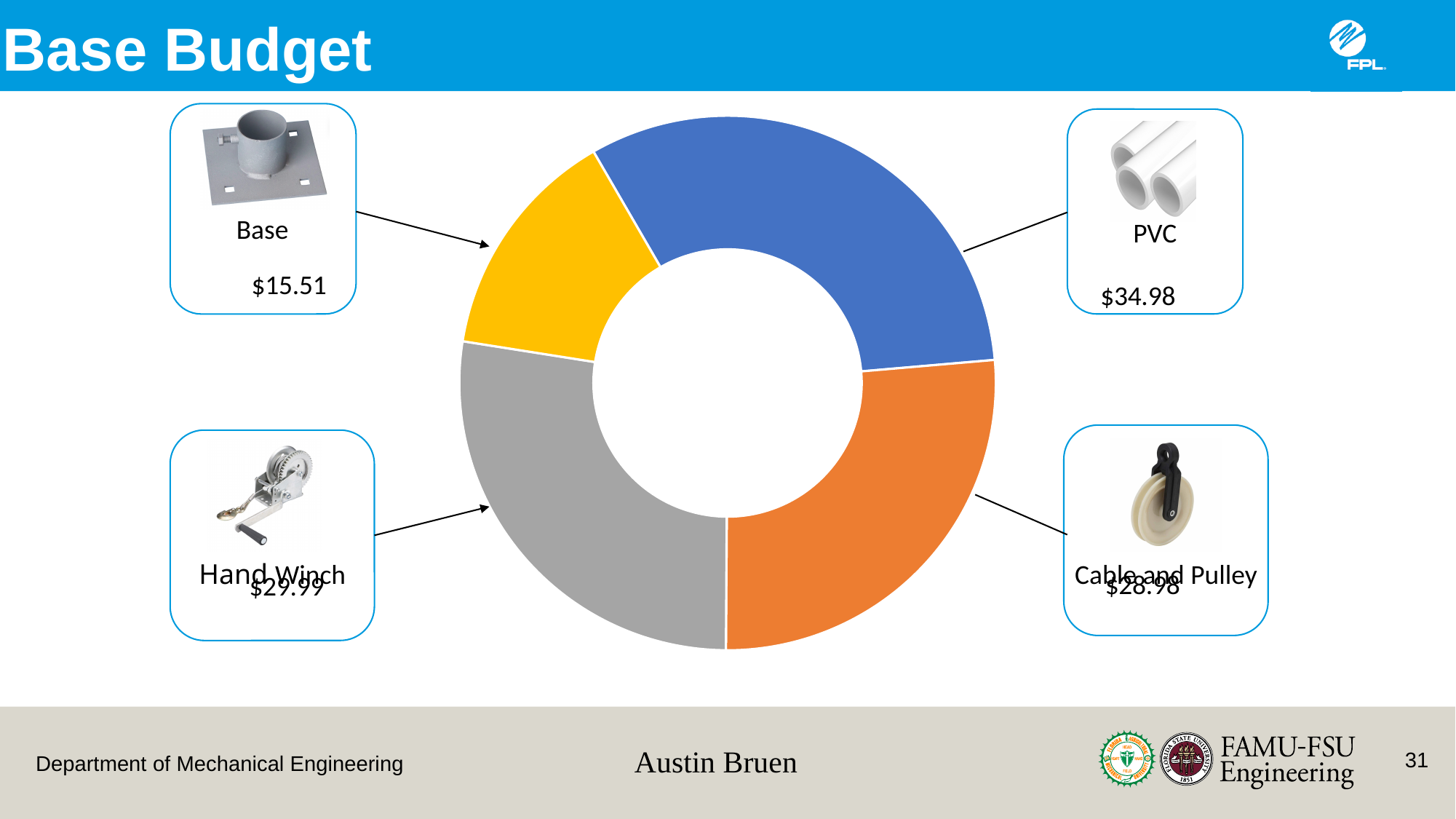
Which component has the highest cost in the Base Budget chart? PVC What is the cost of the Cable and Pulley in the Base Budget chart? $28.98 How many components are shown in the Base Budget chart? 4 What is the cost of the Hand Winch in the Base Budget chart? $29.99 What is the cost of the PVC in the Base Budget chart? $34.98 What is the cost of the Base component in the Base Budget chart? $15.51 How much more does the PVC cost than the Base component? $19.47 What kind of chart is used on the Base Budget slide? Pie chart (donut) What is the total cost of all four components in the Base Budget chart? $109.46 Which costs more, the Hand Winch or the Cable and Pulley? Hand Winch What is the difference in cost between the Hand Winch and the Cable and Pulley? $1.01 Which component has the lowest cost in the Base Budget chart? Base